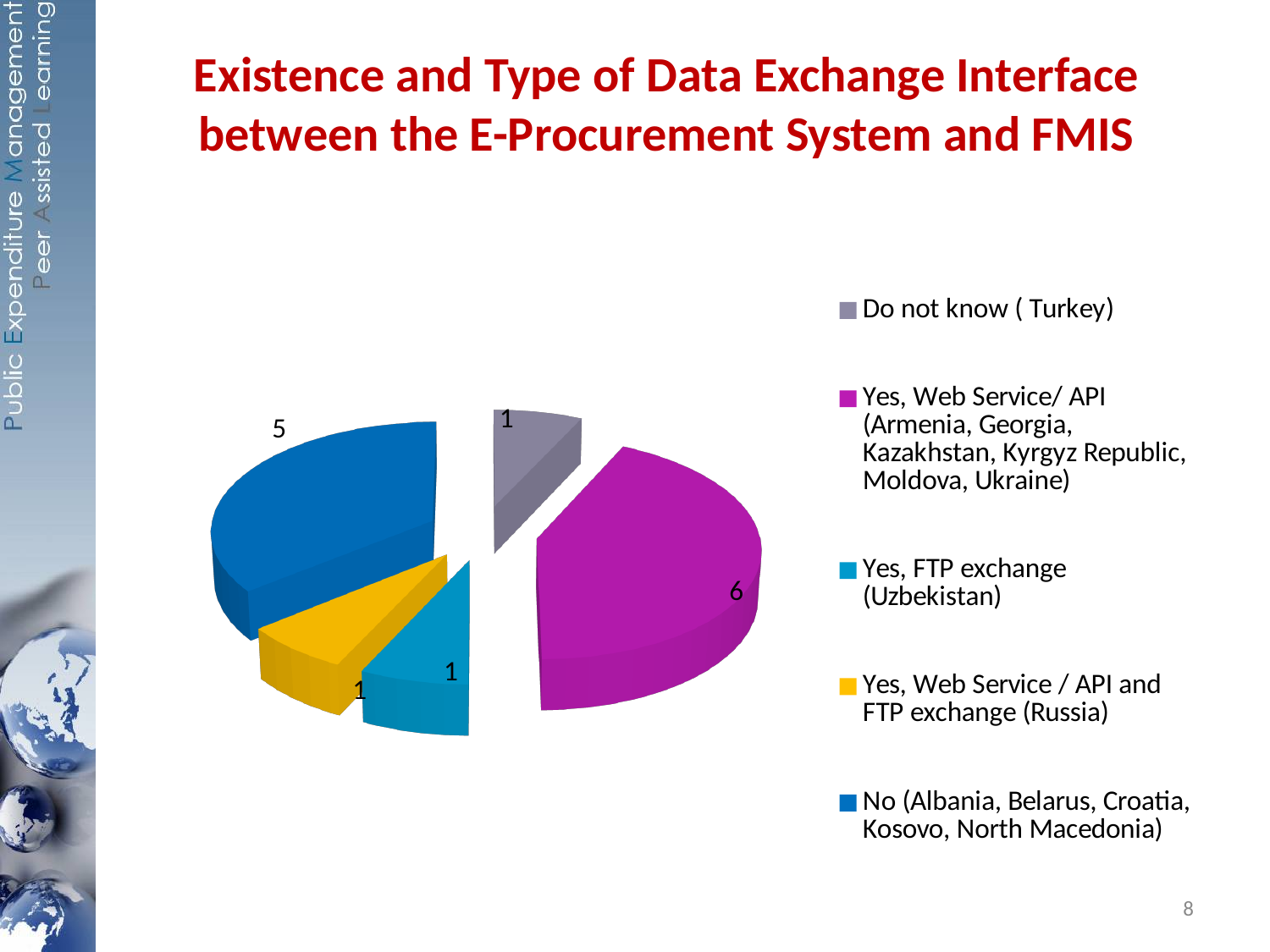
What is the value for the 'Yes, FTP exchange (Uzbekistan)' slice? 1 What is the difference between the 'Yes, Web Service/ API' slice and the 'No' slice? 1 What is the total of all the slice values in the pie chart? 14 What kind of chart is shown on the slide? Pie chart What is the value for the 'Do not know ( Turkey)' slice? 1 What is the value for the 'Yes, Web Service/ API' slice? 6 How many slices does the pie chart have? 5 How many entries does the legend list? 5 Which is larger, the 'No' slice or the 'Yes, Web Service / API and FTP exchange (Russia)' slice? No What colour is the 'Yes, Web Service/ API' slice? Magenta What is the value for the 'No' slice (Albania, Belarus, Croatia, Kosovo, North Macedonia)? 5 Which category has the largest slice of the pie? Yes, Web Service/ API